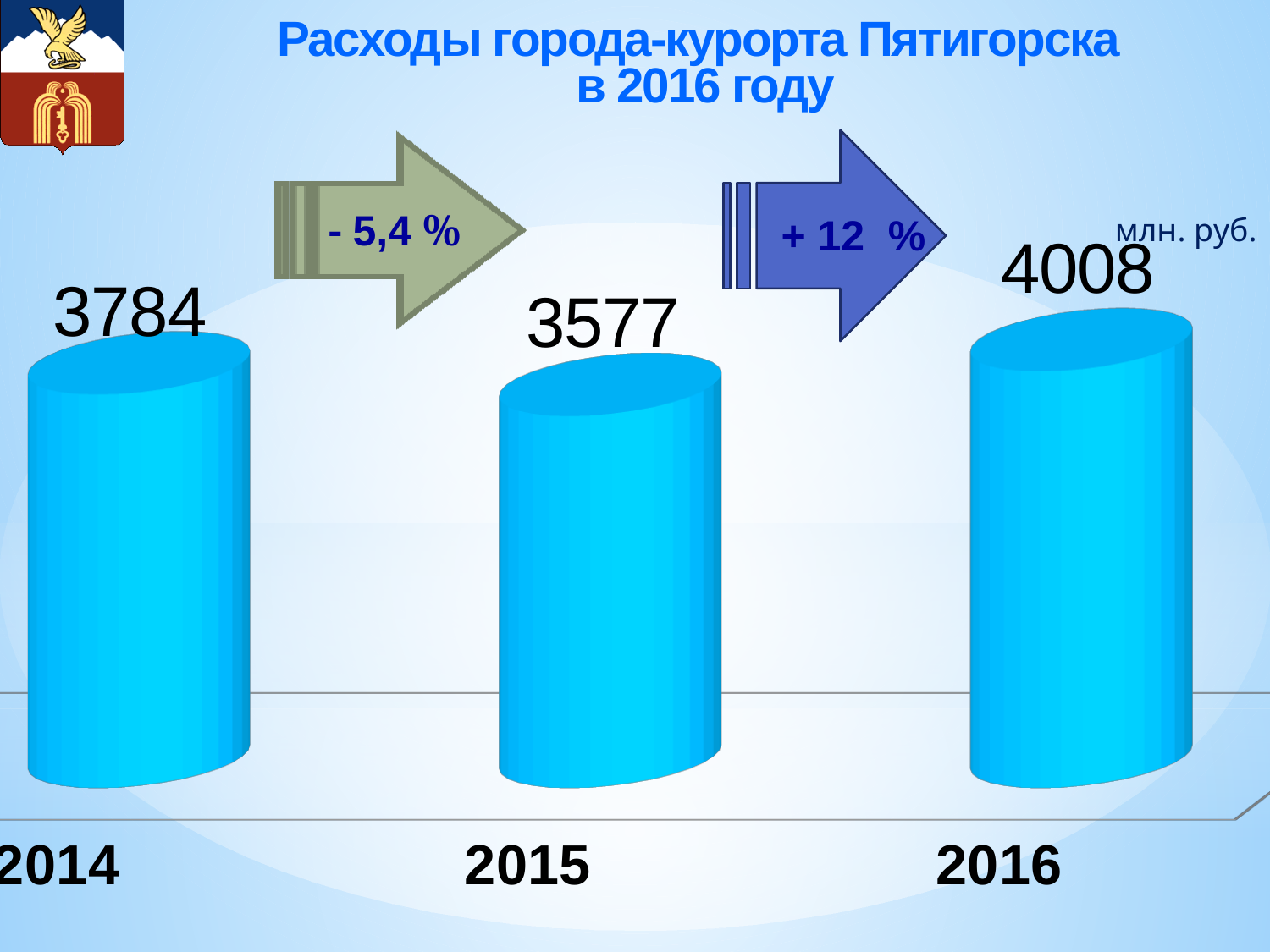
What kind of chart is shown on the slide? bar chart What unit is indicated for the values on the chart? млн. руб. Which year has the highest value? 2016 How many years are shown on the chart? 3 What percentage change is shown between 2015 and 2016? + 12 % What is the value for 2014? 3784 Which year has the lowest value? 2015 What is the difference between the values for 2014 and 2015? 207 What is the value for 2016? 4008 What is the difference between the values for 2016 and 2015? 431 What is the value for 2015? 3577 Which is larger, the value for 2014 or the value for 2016? 2016